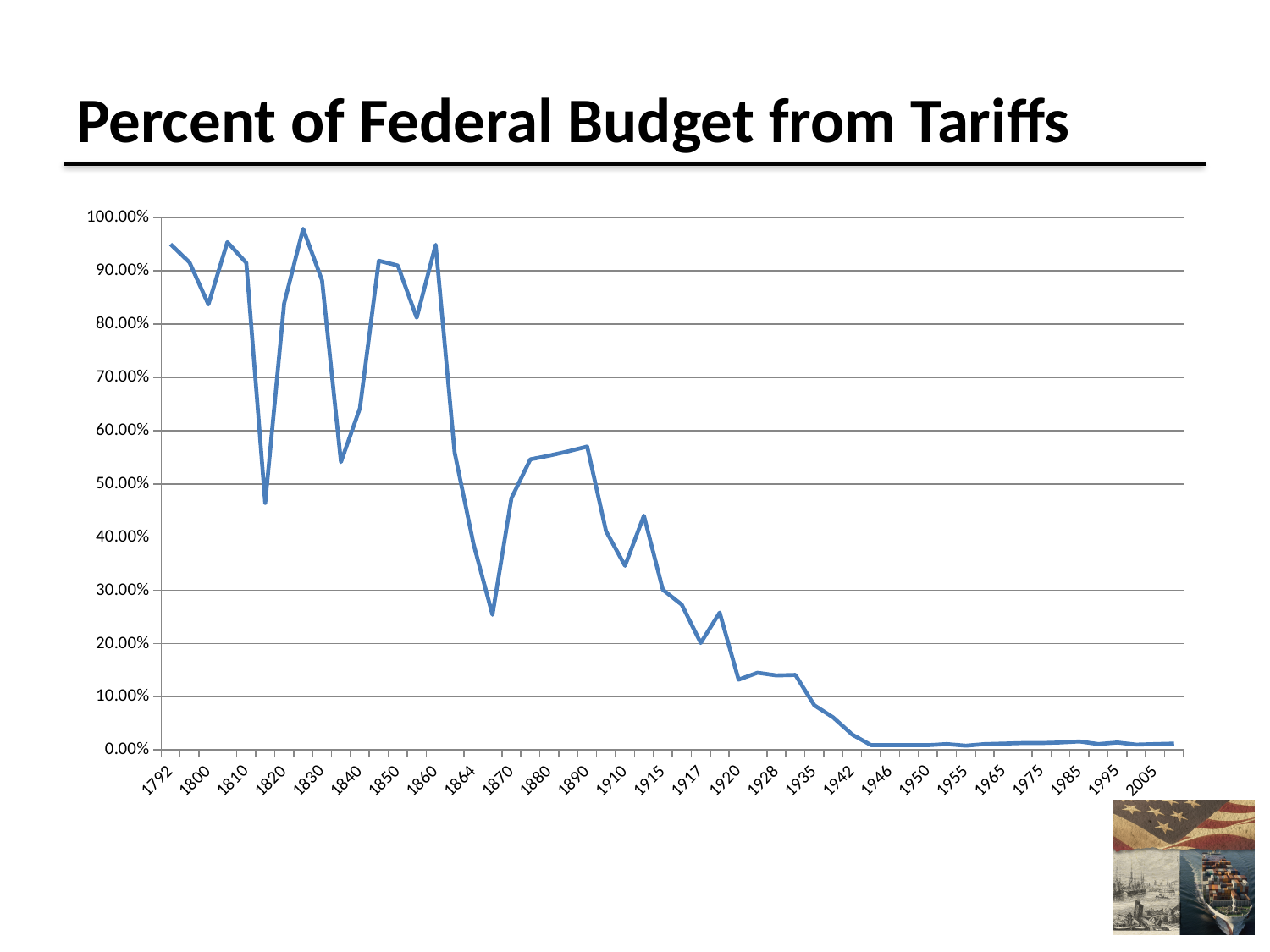
What is the title of the chart? Percent of Federal Budget from Tariffs Is the value for 1946 greater or less than 10.00%? less Overall, do the values rise or fall from 1792 to 2005? fall Is the value for 2005 greater or less than 10.00%? less Is the value for 1870 greater or less than 30.00%? greater What kind of chart is shown on the slide? line chart What is the highest value shown on the vertical axis? 100.00% Which year has the higher value, 1830 or 1870? 1830